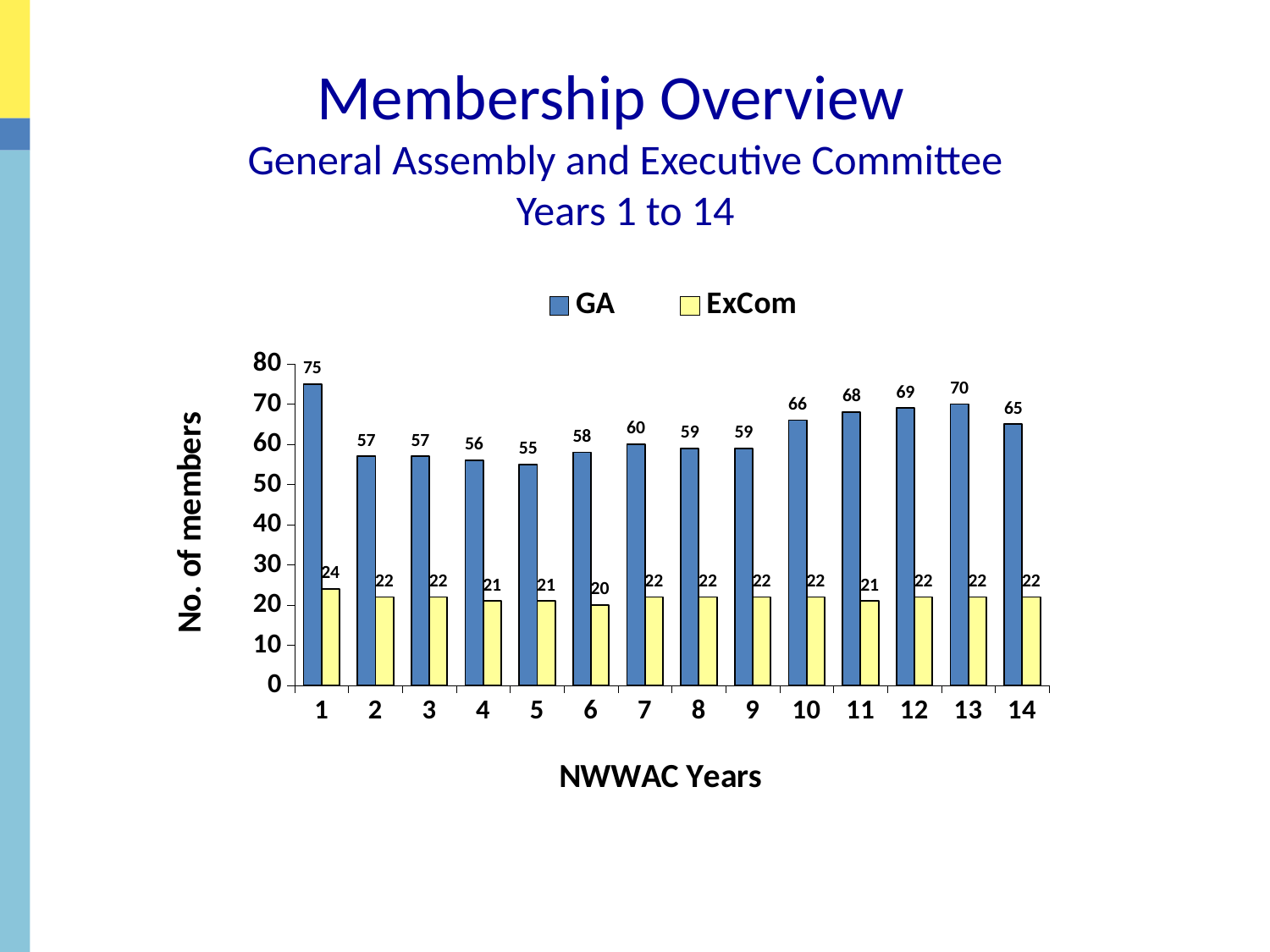
How many series does the legend list? 2 What is the difference between the GA value and the ExCom value in year 14? 43 Which year has the lowest GA value? 5 What is the GA value for year 1? 75 What is the ExCom value for year 6? 20 What is the label of the y axis? No. of members Which is larger, the GA value for year 10 or the GA value for year 7? Year 10 What is the GA value for year 13? 70 What kind of chart is shown on the slide? Bar chart Which year has the highest GA value? 1 Which year has the lowest ExCom value? 6 How many years are shown on the x axis? 14